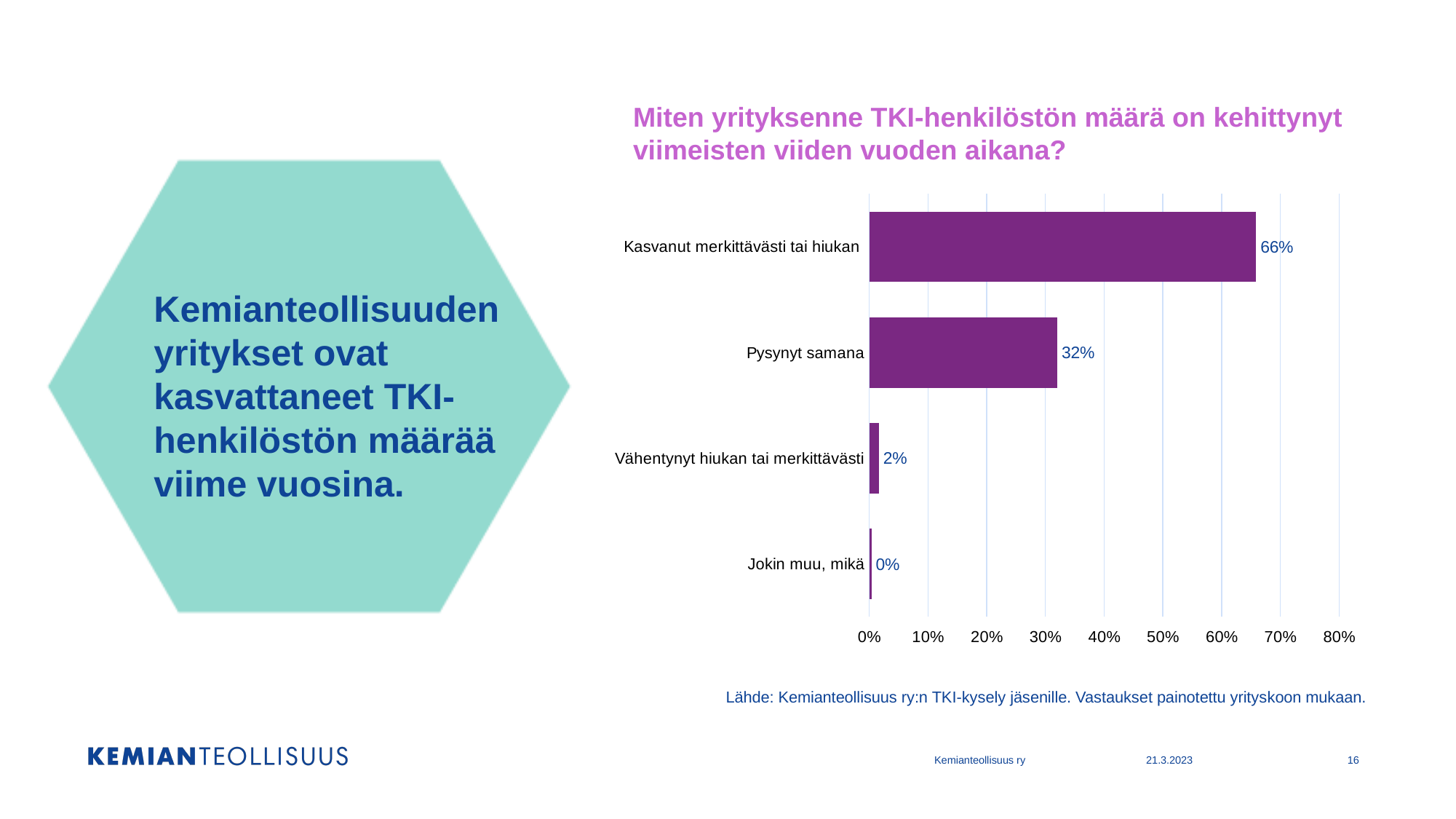
Which category has the highest value? Kasvanut merkittävästi tai hiukan What kind of chart is shown on the slide? bar chart What is the value for "Vähentynyt hiukan tai merkittävästi"? 2% What is the title of the chart? Miten yrityksenne TKI-henkilöstön määrä on kehittynyt viimeisten viiden vuoden aikana? What is the difference between the values for "Kasvanut merkittävästi tai hiukan" and "Pysynyt samana"? 34% How many categories are shown in the chart? 4 Which category has the lowest value? Jokin muu, mikä Is the value for "Kasvanut merkittävästi tai hiukan" greater or less than 60%? greater Which is larger, the value for "Pysynyt samana" or the value for "Vähentynyt hiukan tai merkittävästi"? Pysynyt samana What is the value for "Jokin muu, mikä"? 0% What is the value for "Kasvanut merkittävästi tai hiukan"? 66% What is the value for "Pysynyt samana"? 32%